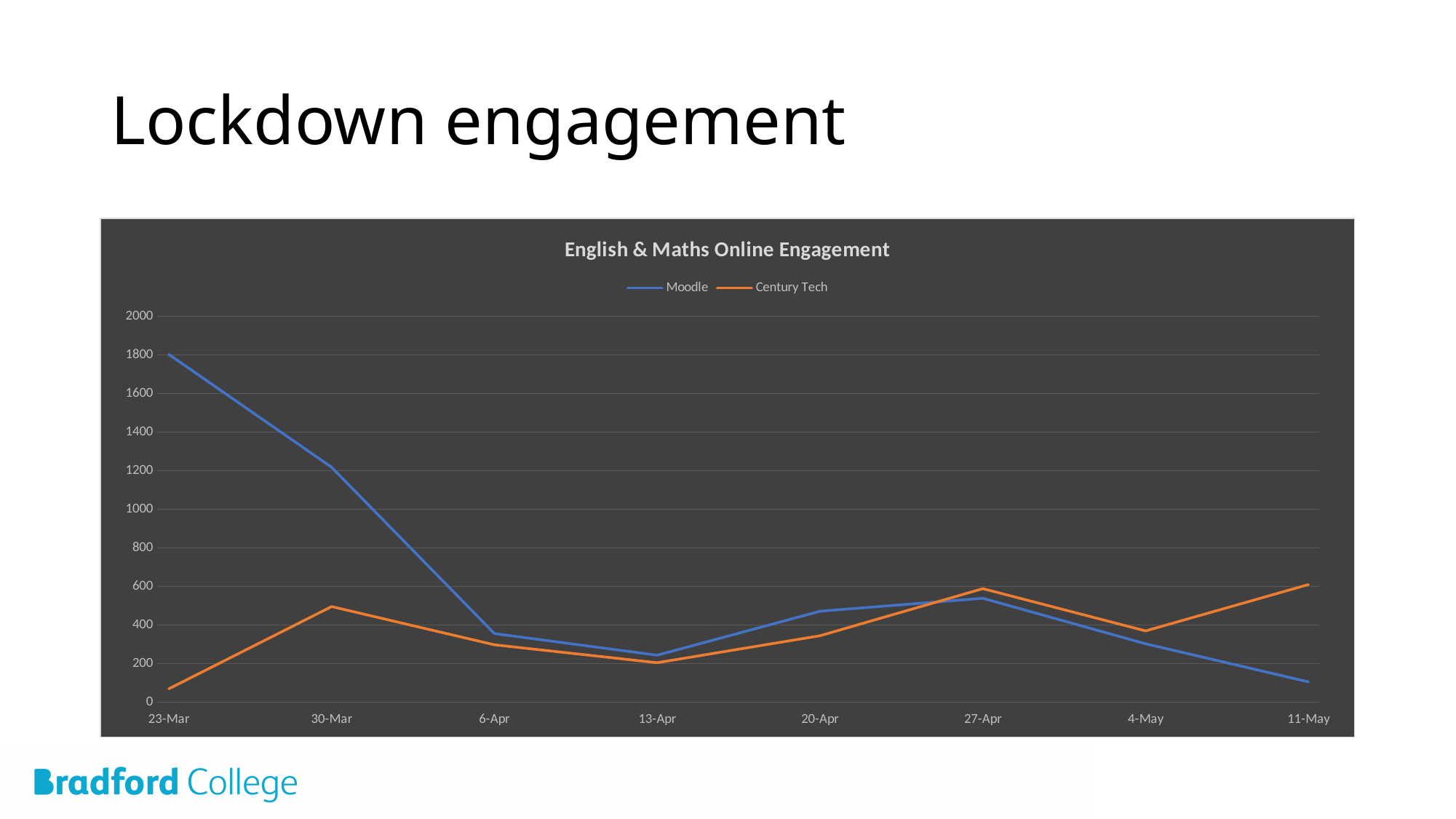
How many series does the legend list? 2 On which date is the Moodle value lowest? 11-May On which date is the Century Tech value lowest? 23-Mar Which series is drawn in orange? Century Tech On which date is the Moodle value highest? 23-Mar Is the Moodle value on 30-Mar greater or less than 1000? greater What kind of chart is shown on the slide? line chart What is the title of the chart? English & Maths Online Engagement How many dates are shown along the x axis? 8 Is the Moodle value on 11-May greater or less than 200? less On 11-May, which series has the larger value, Moodle or Century Tech? Century Tech